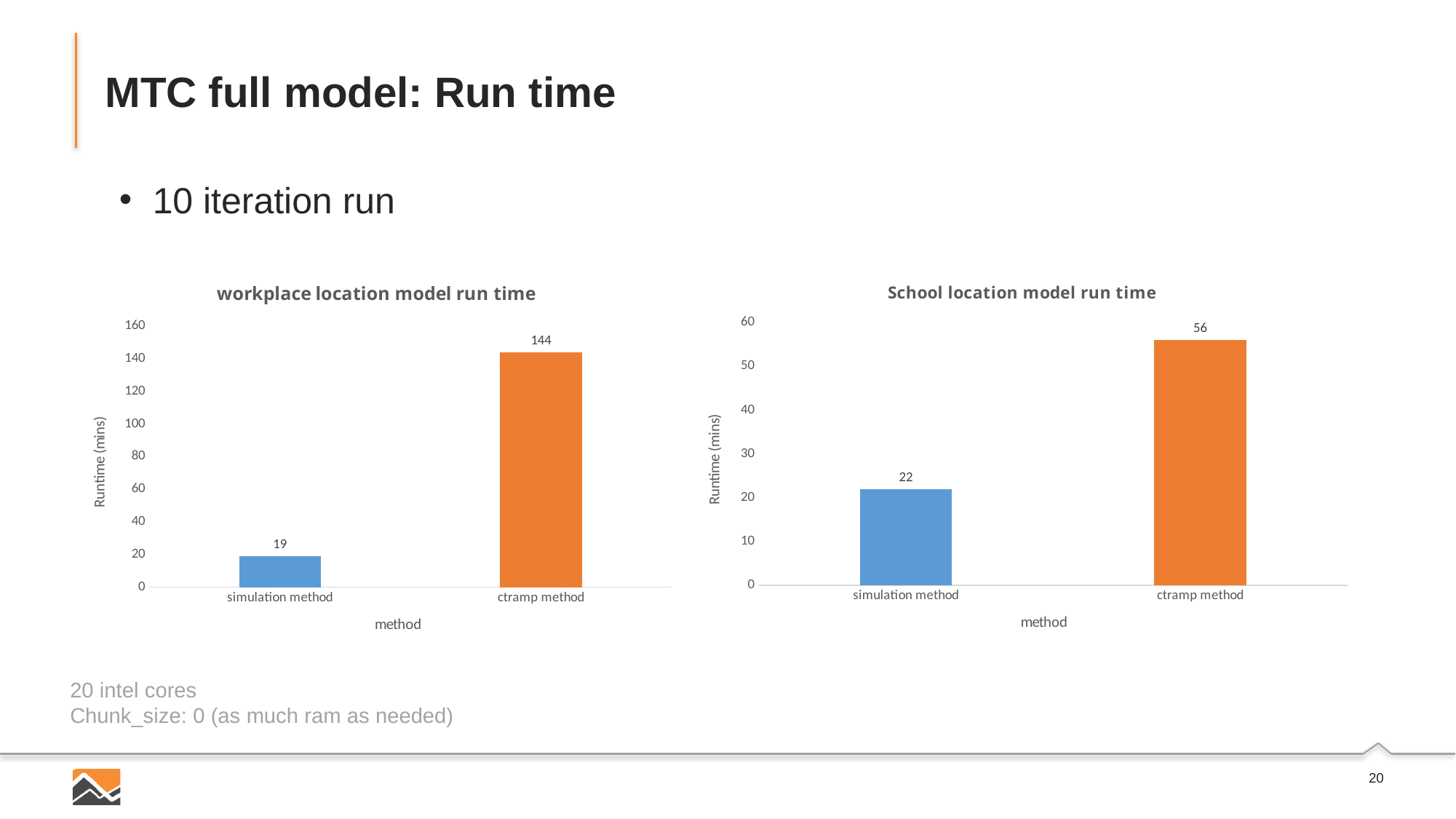
In the 'School location model run time' chart, which method has the lowest runtime? simulation method What kind of chart is the 'School location model run time' chart? bar chart In the 'workplace location model run time' chart, which method has the highest runtime? ctramp method In the 'School location model run time' chart, what is the difference in runtime between the ctramp method and the simulation method? 34 In the 'workplace location model run time' chart, what is the runtime for the ctramp method? 144 In the 'workplace location model run time' chart, what is the difference in runtime between the ctramp method and the simulation method? 125 In the 'School location model run time' chart, which is larger: the runtime for the simulation method or the ctramp method? ctramp method How many methods are shown on the x axis of the 'workplace location model run time' chart? 2 In the 'workplace location model run time' chart, what is the runtime for the simulation method? 19 In the 'School location model run time' chart, what is the runtime for the ctramp method? 56 What is the y-axis label of the 'workplace location model run time' chart? Runtime (mins) In the 'School location model run time' chart, what is the runtime for the simulation method? 22